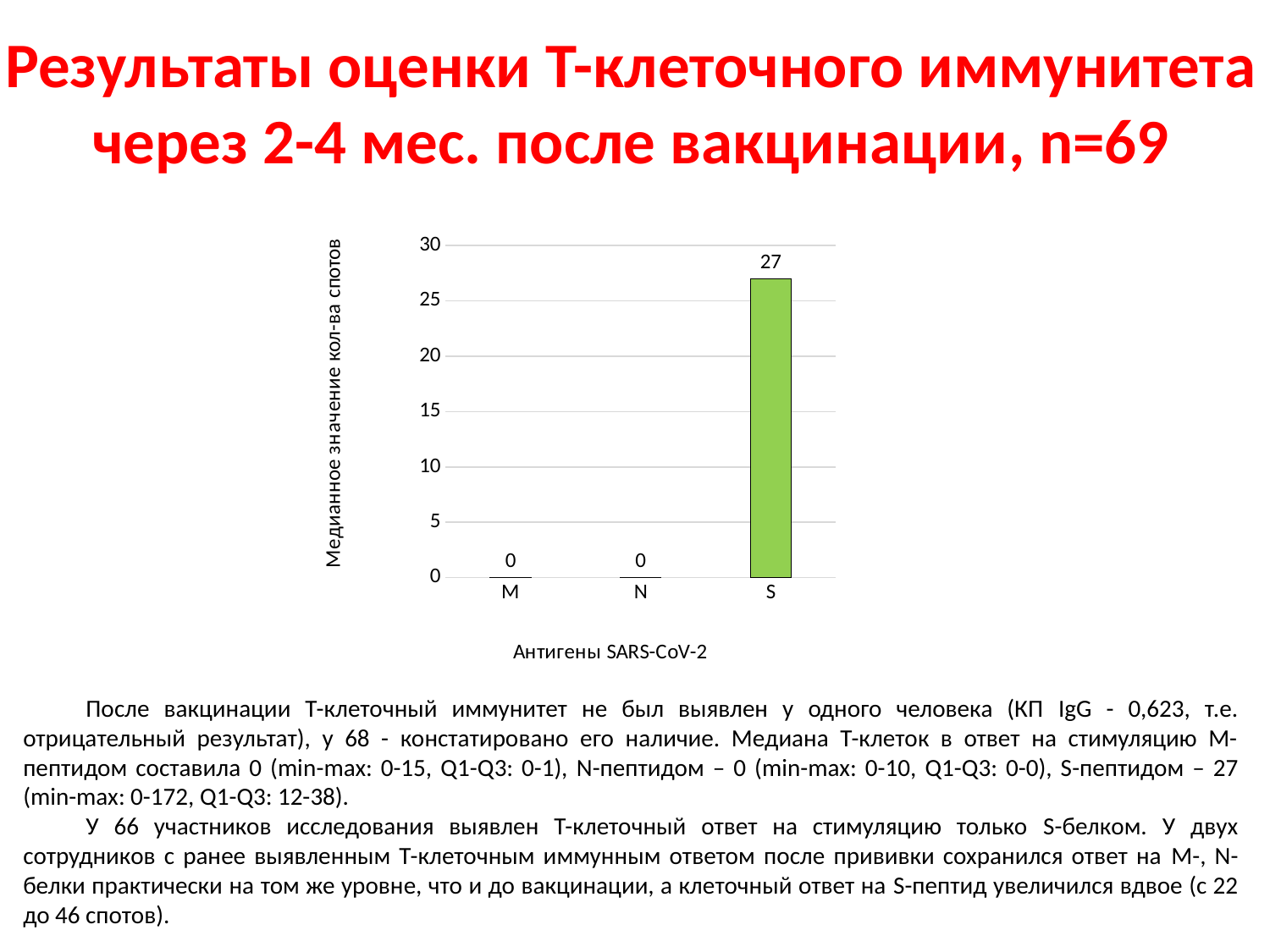
What is the difference between the values for S and M? 27 Is the value for S greater or less than 25? greater What kind of chart is shown on the slide? bar chart What is the maximum value shown on the y axis? 30 What is the label of the x axis? Антигены SARS-CoV-2 Which antigen has the highest median number of spots? S What is the label of the y axis? Медианное значение кол-ва спотов What is the value for the N antigen? 0 Which is larger, the value for S or the value for N? S What is the value for the M antigen? 0 How many antigen categories are shown on the x axis? 3 What is the value for the S antigen? 27